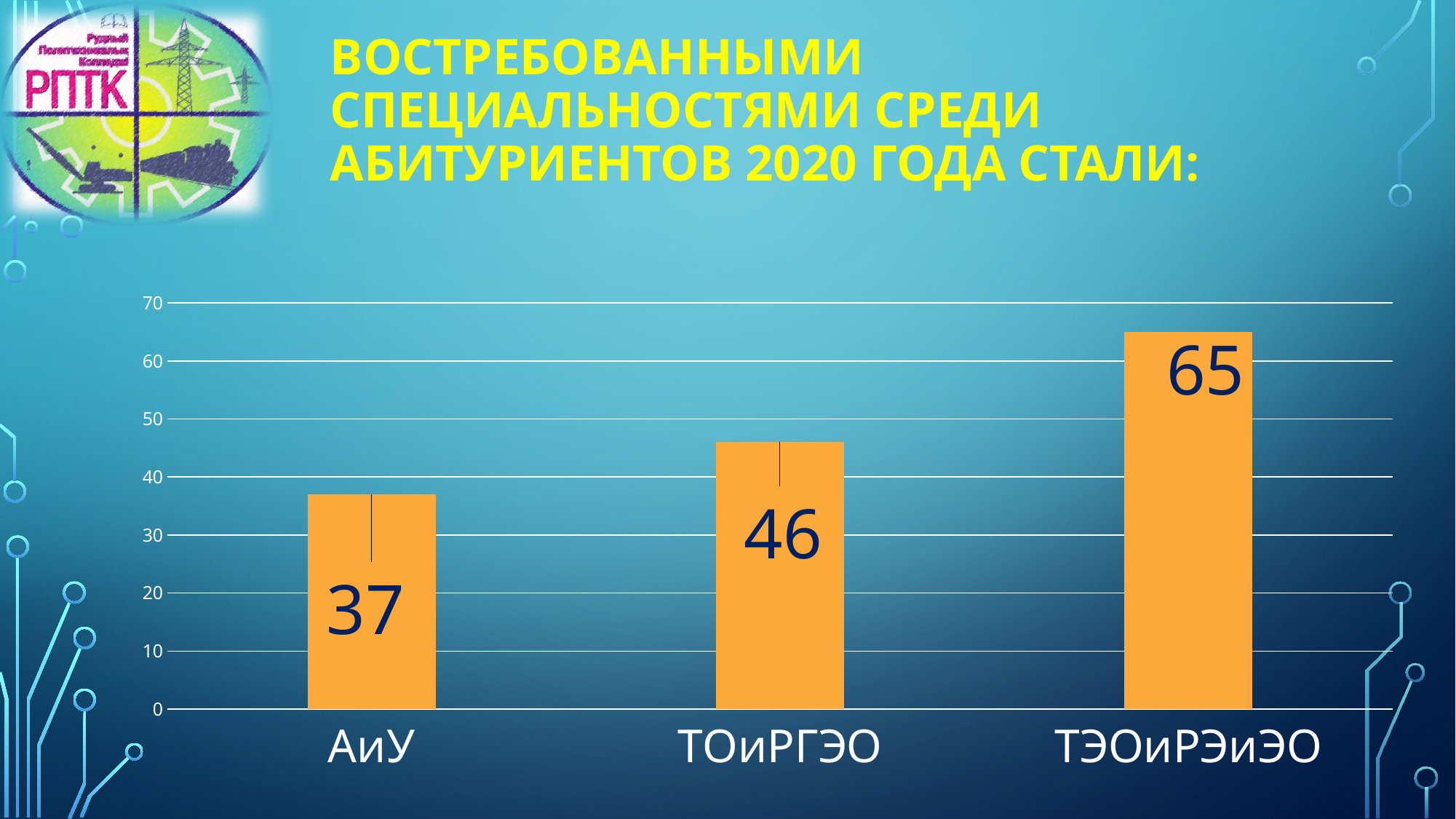
What kind of chart is shown on the slide? bar chart Do the values rise or fall from left to right along the x axis? rise Which is larger, the value for ТОиРГЭО or the value for АиУ? ТОиРГЭО What is the difference between the values for ТЭОиРЭиЭО and АиУ? 28 Which category has the lowest value? АиУ What is the value for ТОиРГЭО? 46 Is the value for ТЭОиРЭиЭО greater or less than 60? greater What is the value for АиУ? 37 Which category has the highest value? ТЭОиРЭиЭО What is the difference between the values for ТОиРГЭО and АиУ? 9 What is the value for ТЭОиРЭиЭО? 65 How many categories are shown on the chart? 3